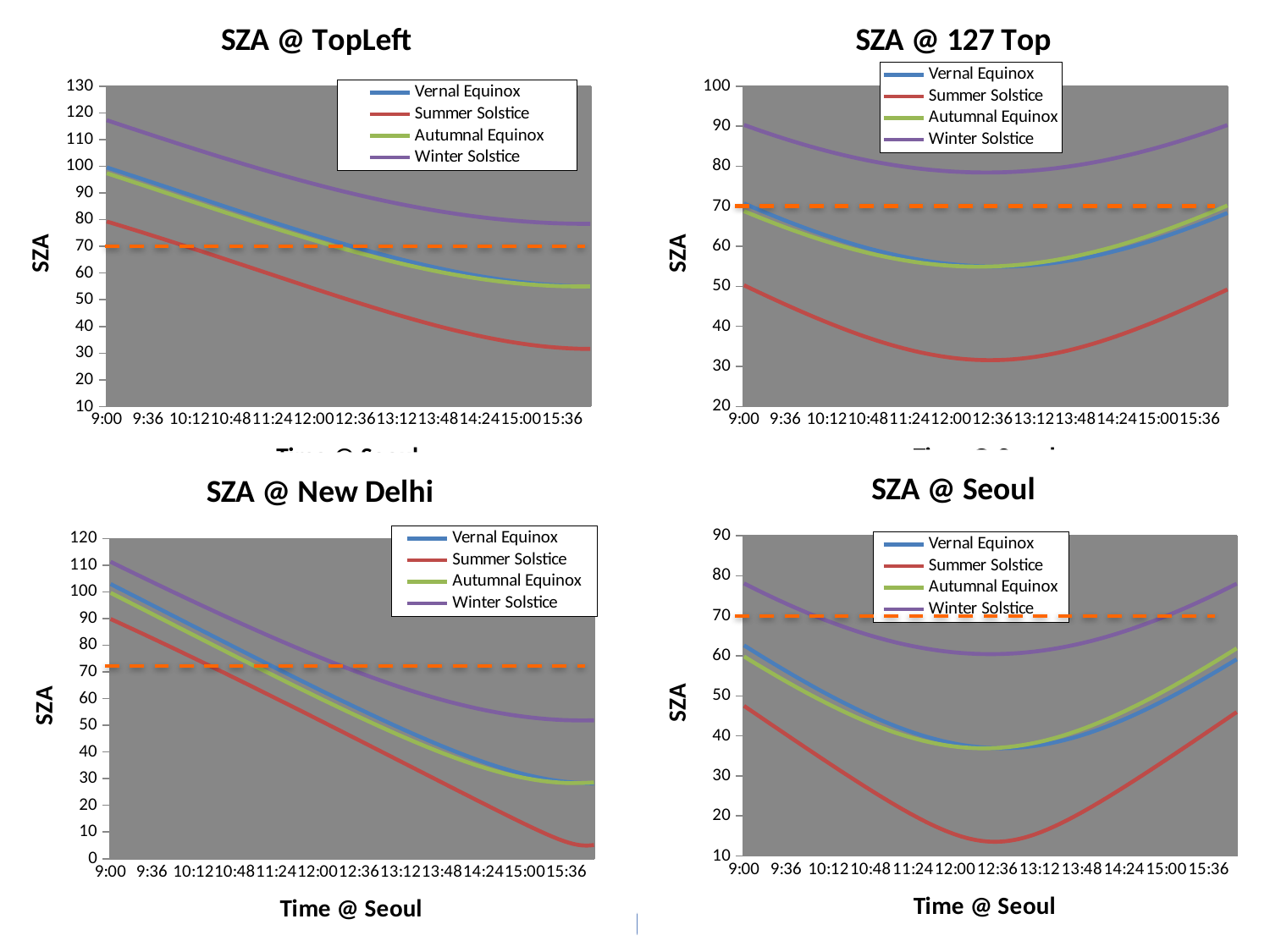
In 'SZA @ 127 Top', is the value for Summer Solstice at 12:36 greater or less than 40? less What kind of chart is 'SZA @ TopLeft'? line chart In 'SZA @ New Delhi', which is larger at 9:00, Winter Solstice or Summer Solstice? Winter Solstice How many series does the legend of 'SZA @ Seoul' list? 4 In 'SZA @ TopLeft', is the value for Winter Solstice at 9:00 greater or less than 100? greater In 'SZA @ Seoul', which series has the highest values across the whole time range? Winter Solstice In 'SZA @ New Delhi', does the Summer Solstice line rise or fall from 9:00 to 15:36? fall What is the y-axis title of the 'SZA @ New Delhi' chart? SZA In 'SZA @ Seoul', does the Summer Solstice line rise or fall from 12:36 to 15:36? rise In 'SZA @ 127 Top', which series has the lowest values across the whole time range? Summer Solstice What is the x-axis title of the 'SZA @ Seoul' chart? Time @ Seoul In 'SZA @ Seoul', is the value for Summer Solstice at 12:36 greater or less than 20? less